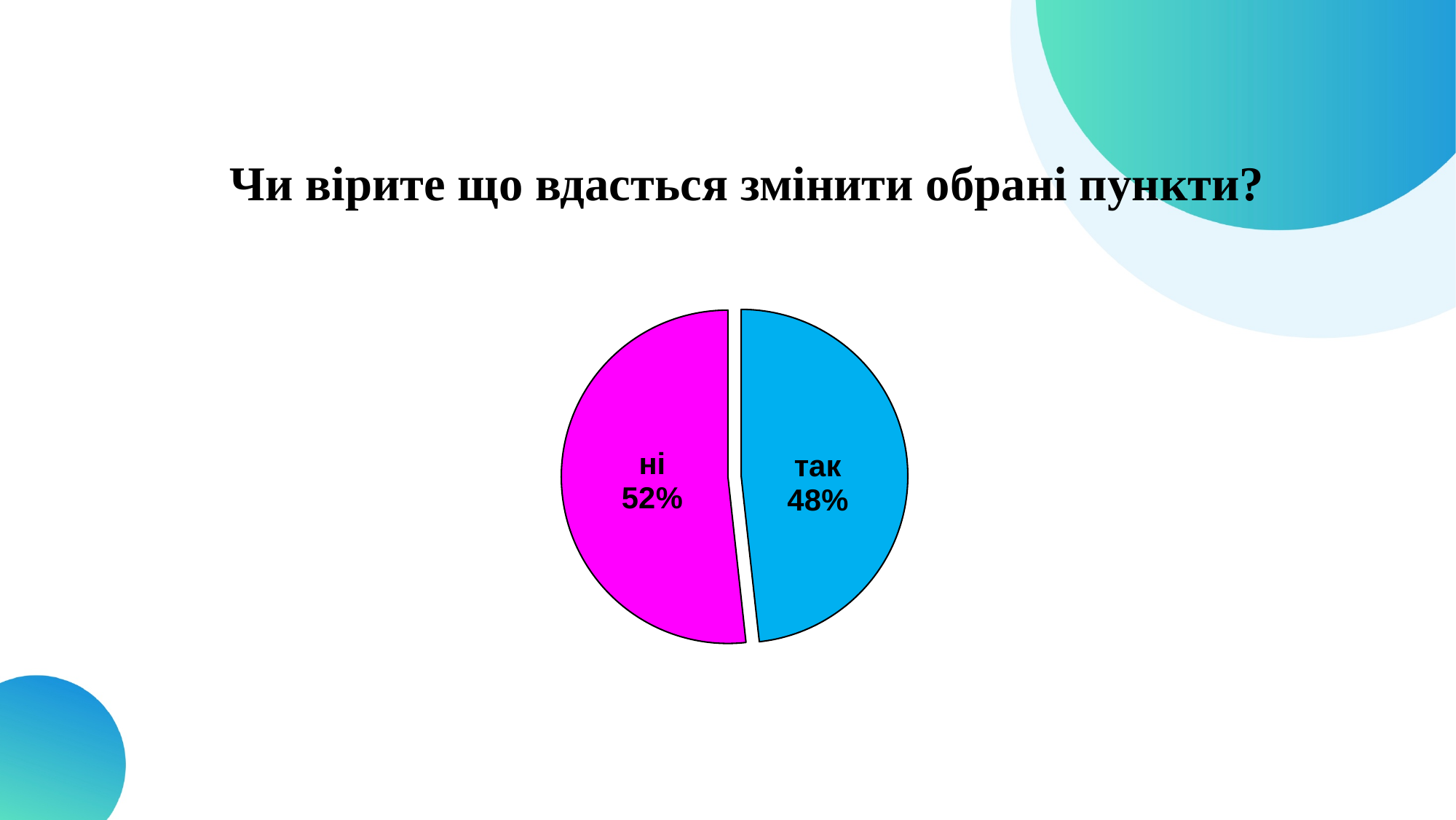
What share of the pie does the "так" slice represent? 48% What is the difference in percentage points between the "ні" and "так" slices? 4% Which slice is the largest in the pie chart? ні How many slices does the pie chart have? 2 What colour is the "так" slice? blue Which slice is the smallest in the pie chart? так What is the title of the slide above the chart? Чи вірите що вдасться змінити обрані пункти? What share of the pie does the "ні" slice represent? 52% What kind of chart is shown on the slide? pie chart Which is larger, the "ні" slice or the "так" slice? ні